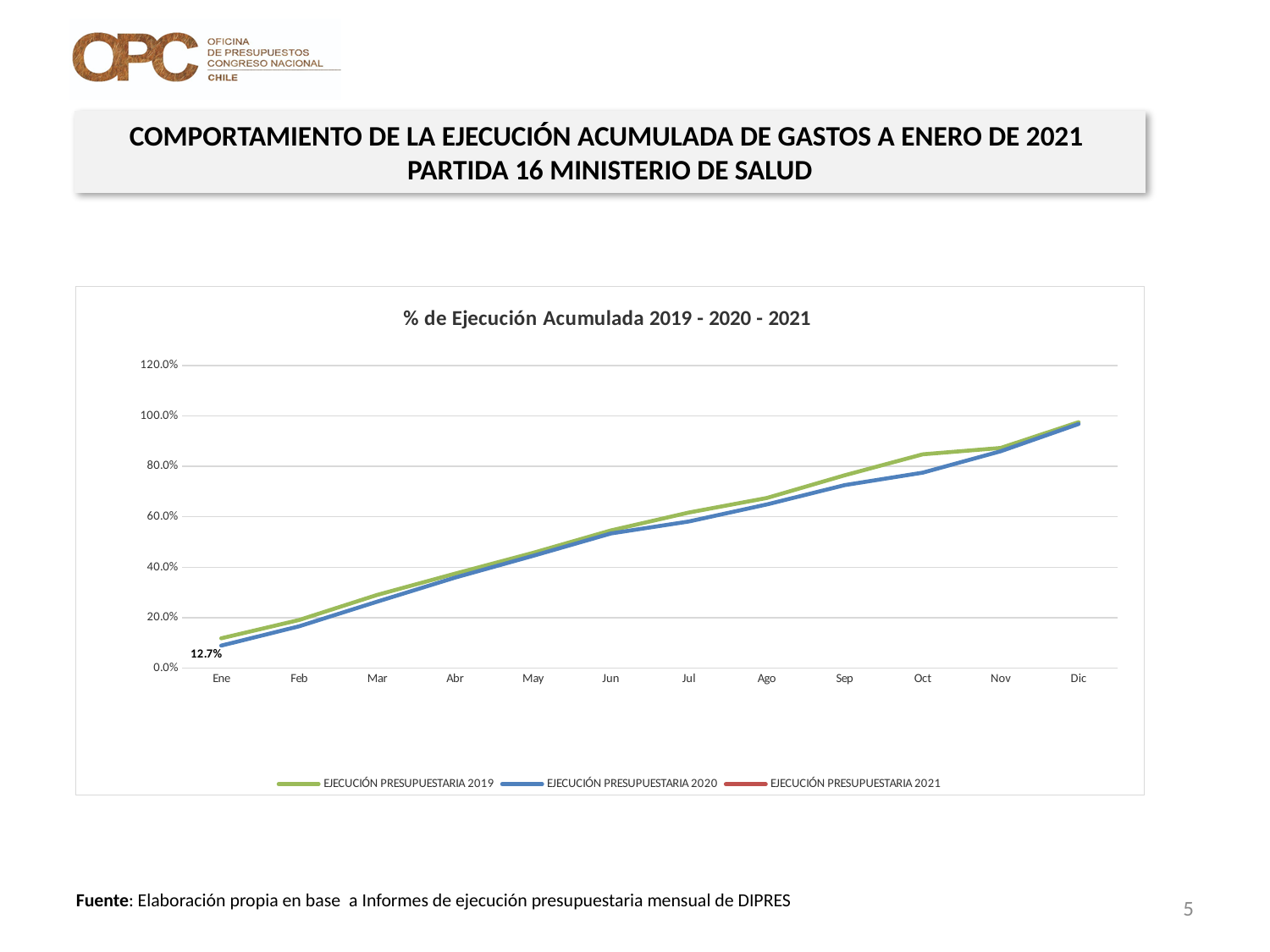
Is the value for EJECUCIÓN PRESUPUESTARIA 2020 in Oct greater or less than 80.0%? less How many series does the chart legend list? 3 In which month is EJECUCIÓN PRESUPUESTARIA 2019 at its lowest value? Ene What is the title of the chart? % de Ejecución Acumulada 2019 - 2020 - 2021 What value is printed as a data label near Ene on the chart? 12.7% What kind of chart is shown on the slide? line chart In which month does EJECUCIÓN PRESUPUESTARIA 2020 reach its highest value? Dic How many months are shown along the x axis of the chart? 12 Do the values for EJECUCIÓN PRESUPUESTARIA 2019 rise or fall from Ene to Dic? rise In Sep, which series has the higher value, EJECUCIÓN PRESUPUESTARIA 2019 or EJECUCIÓN PRESUPUESTARIA 2020? EJECUCIÓN PRESUPUESTARIA 2019 What colour is the line for EJECUCIÓN PRESUPUESTARIA 2020? blue Is the value for EJECUCIÓN PRESUPUESTARIA 2019 in Oct greater or less than 80.0%? greater